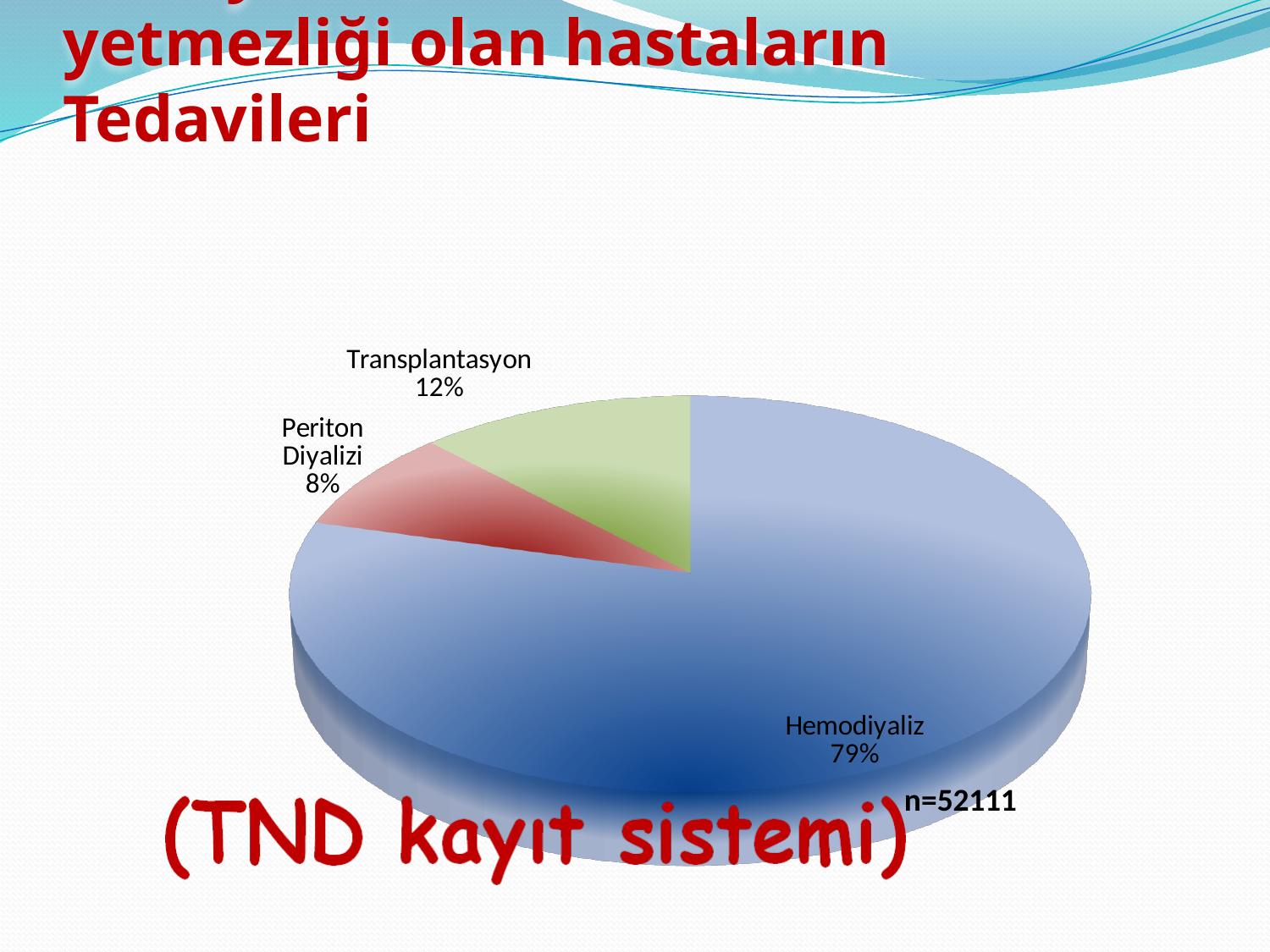
What is the total number of patients (n) stated on the slide? n=52111 Which has a larger share, Transplantasyon or Periton Diyalizi? Transplantasyon What is the difference in percentage points between Hemodiyaliz and Transplantasyon? 67 What percentage of patients receive Hemodiyaliz? 79% What is the difference in percentage points between Transplantasyon and Periton Diyalizi? 4 What percentage of patients receive Periton Diyalizi? 8% What colour is the Transplantasyon slice? Green Which treatment has the smallest share of the pie? Periton Diyalizi What percentage of patients receive Transplantasyon? 12% How many slices does the pie chart have? 3 Which treatment has the largest share of the pie? Hemodiyaliz What kind of chart is shown on the slide? Pie chart